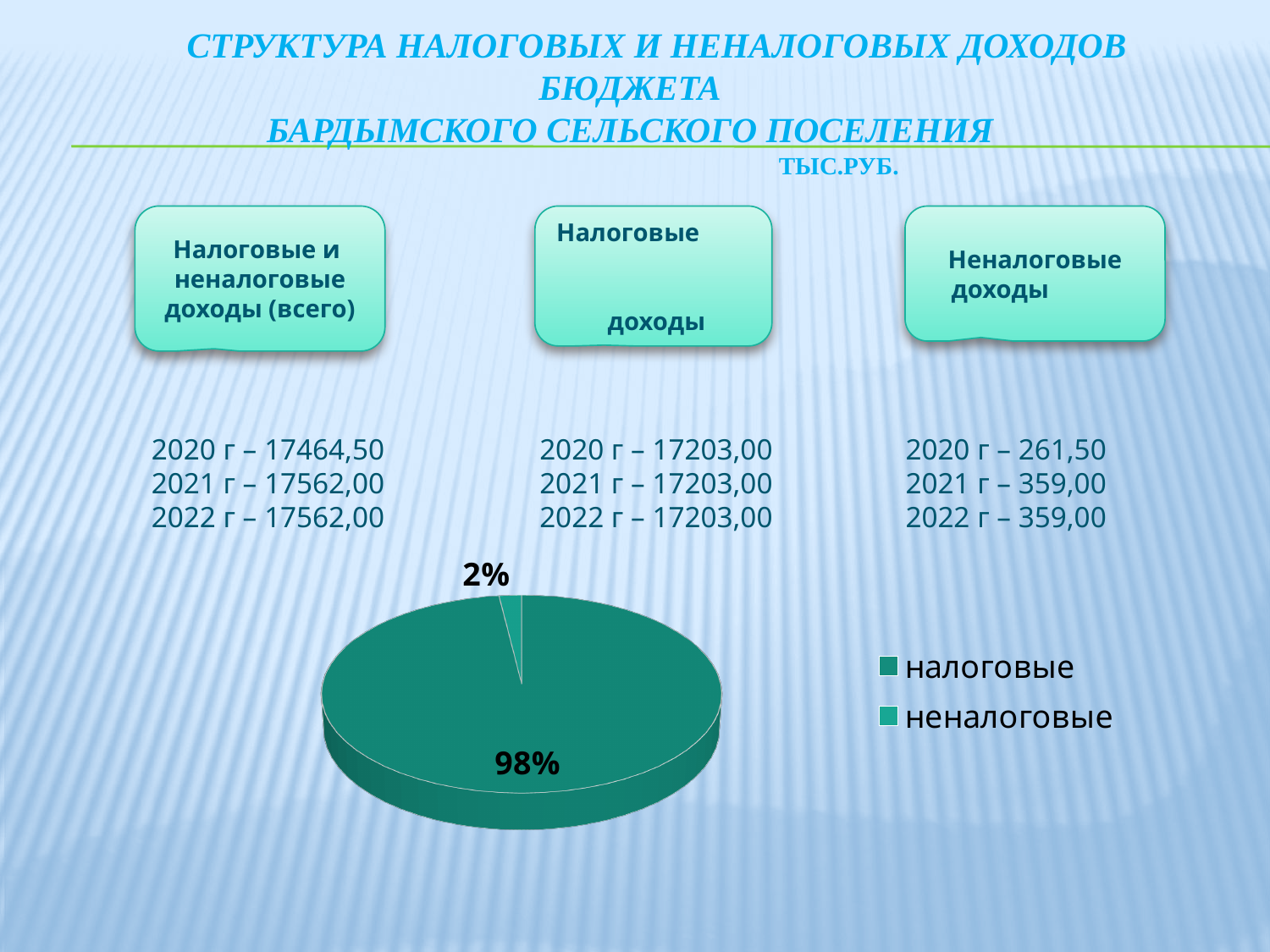
What share of the pie does the налоговые slice represent? 98% What is the total of the two percentages shown on the pie chart? 100% How many entries does the legend of the pie chart list? 2 Which slice of the pie chart is the smallest? неналоговые How many slices does the pie chart have? 2 What share of the pie does the неналоговые slice represent? 2% What kind of chart is shown on the slide? pie chart Which slice of the pie chart is the largest? налоговые What are the two legend entries of the pie chart? налоговые, неналоговые What is the difference in percentage points between the налоговые and неналоговые slices? 96 Which is larger in the pie chart: налоговые or неналоговые? налоговые